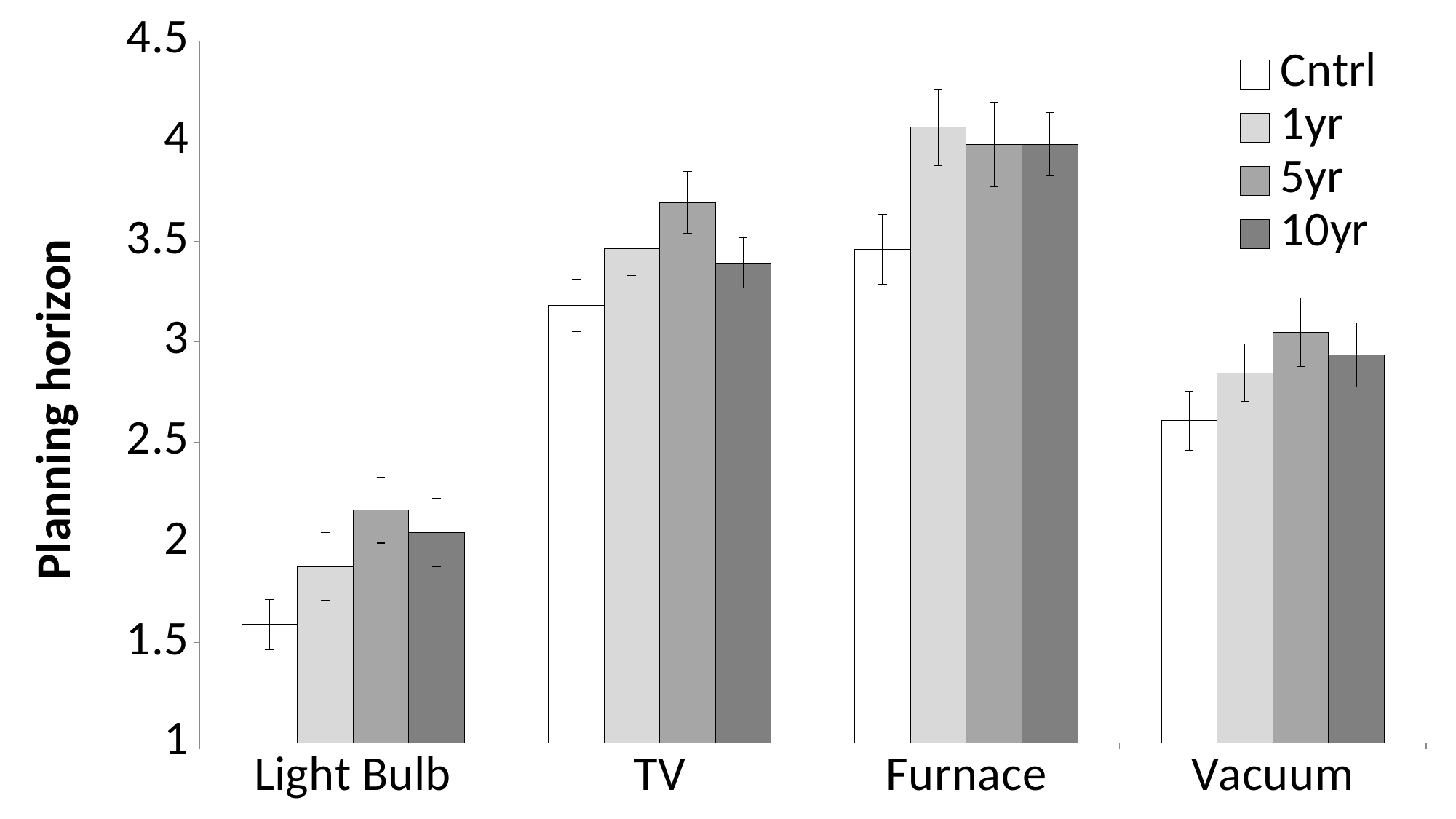
How many product categories are shown on the x axis? 4 What are the four legend entries? Cntrl, 1yr, 5yr, 10yr Which product category has the lowest Cntrl value? Light Bulb What kind of chart is shown on the slide? bar chart How many series does the legend list? 4 Is the 1yr value for Furnace greater or less than 4? greater Is the Cntrl value for Vacuum greater or less than 2.5? greater For TV, which series has the highest planning horizon? 5yr Which product category has the highest Cntrl value? Furnace Is the Cntrl value for TV greater or less than 3? greater What is the title of the y axis? Planning horizon